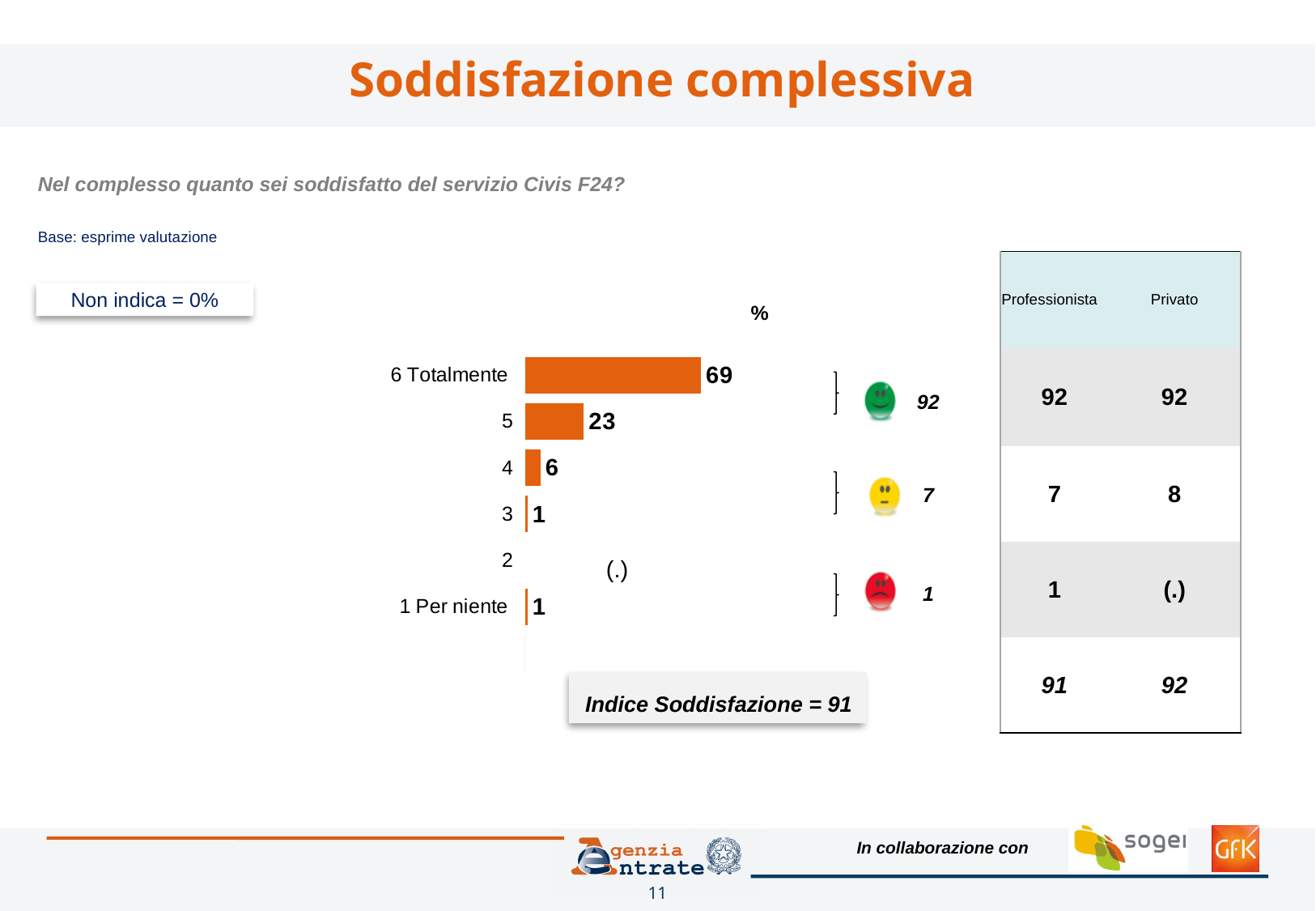
What is the value of the "Indice Soddisfazione" shown below the chart? 91 What is the combined value shown next to the green smiley face (ratings 5 and 6)? 92 Which rating category has the highest value? 6 Totalmente How many rating categories are shown on the chart? 6 What kind of chart is used to show the satisfaction ratings? Bar chart What percentage of respondents gave the rating "6 Totalmente"? 69 What is the difference between the values for "6 Totalmente" and rating 5? 46 What is the value shown for "1 Per niente"? 1 What is the value shown for rating 4? 6 Which is larger, the value for rating 5 or the value for rating 4? Rating 5 What is the value shown for rating 2 on the chart? (.) What is the value shown for rating 5? 23